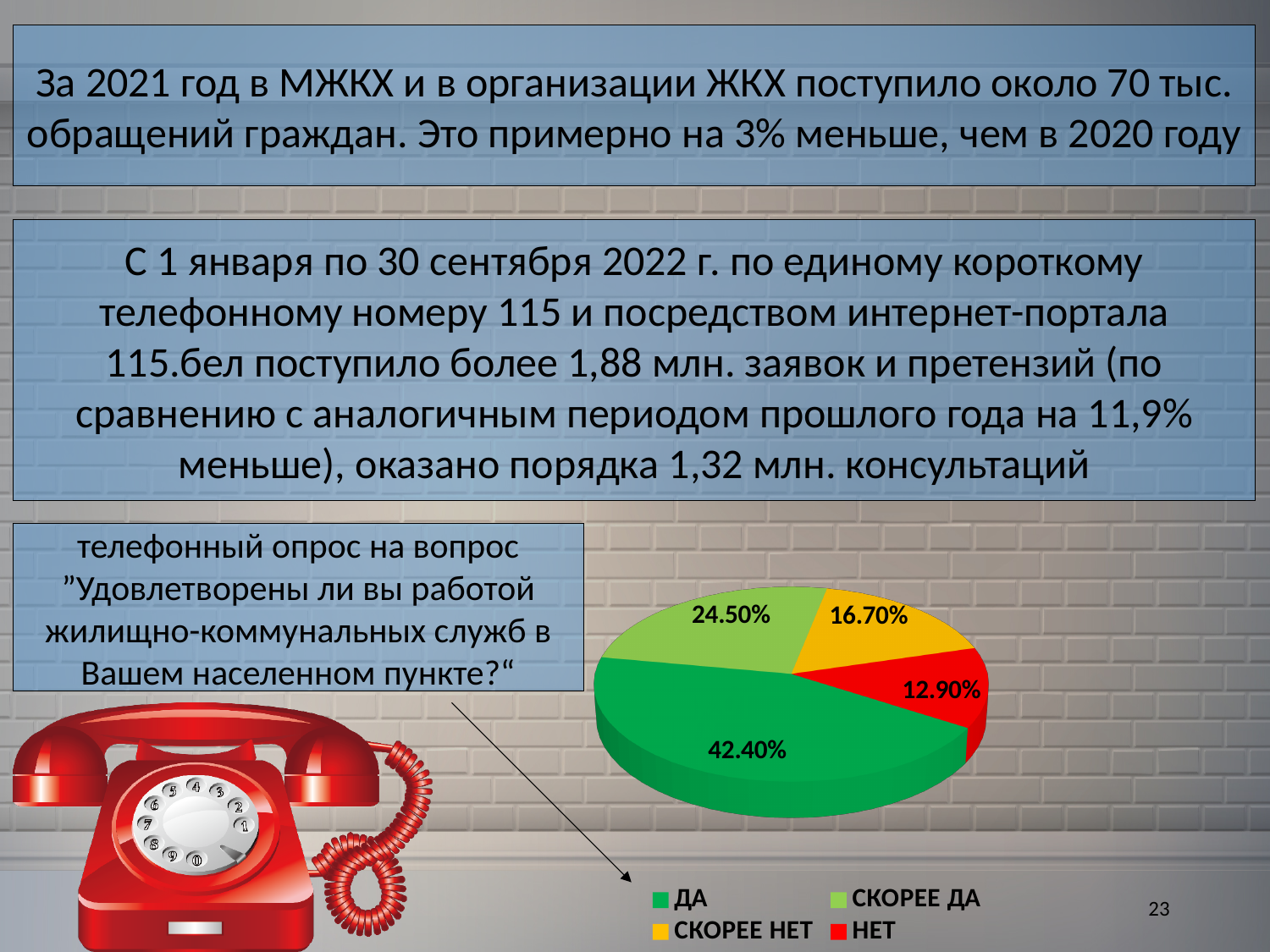
What kind of chart is shown on the slide? pie chart What share of respondents answered "СКОРЕЕ НЕТ" in the pie chart? 16.70% What is the difference in percentage points between the "ДА" and "НЕТ" slices? 29.50% What share of respondents answered "ДА" in the pie chart? 42.40% What share of respondents answered "СКОРЕЕ ДА" in the pie chart? 24.50% Which slice is larger in the pie chart: "СКОРЕЕ ДА" or "СКОРЕЕ НЕТ"? СКОРЕЕ ДА What share of respondents answered "НЕТ" in the pie chart? 12.90% Which answer has the largest slice in the pie chart? ДА What colour is the "НЕТ" slice in the pie chart? red How many entries does the legend of the pie chart list? 4 Which answer has the smallest slice in the pie chart? НЕТ How many slices does the pie chart have? 4